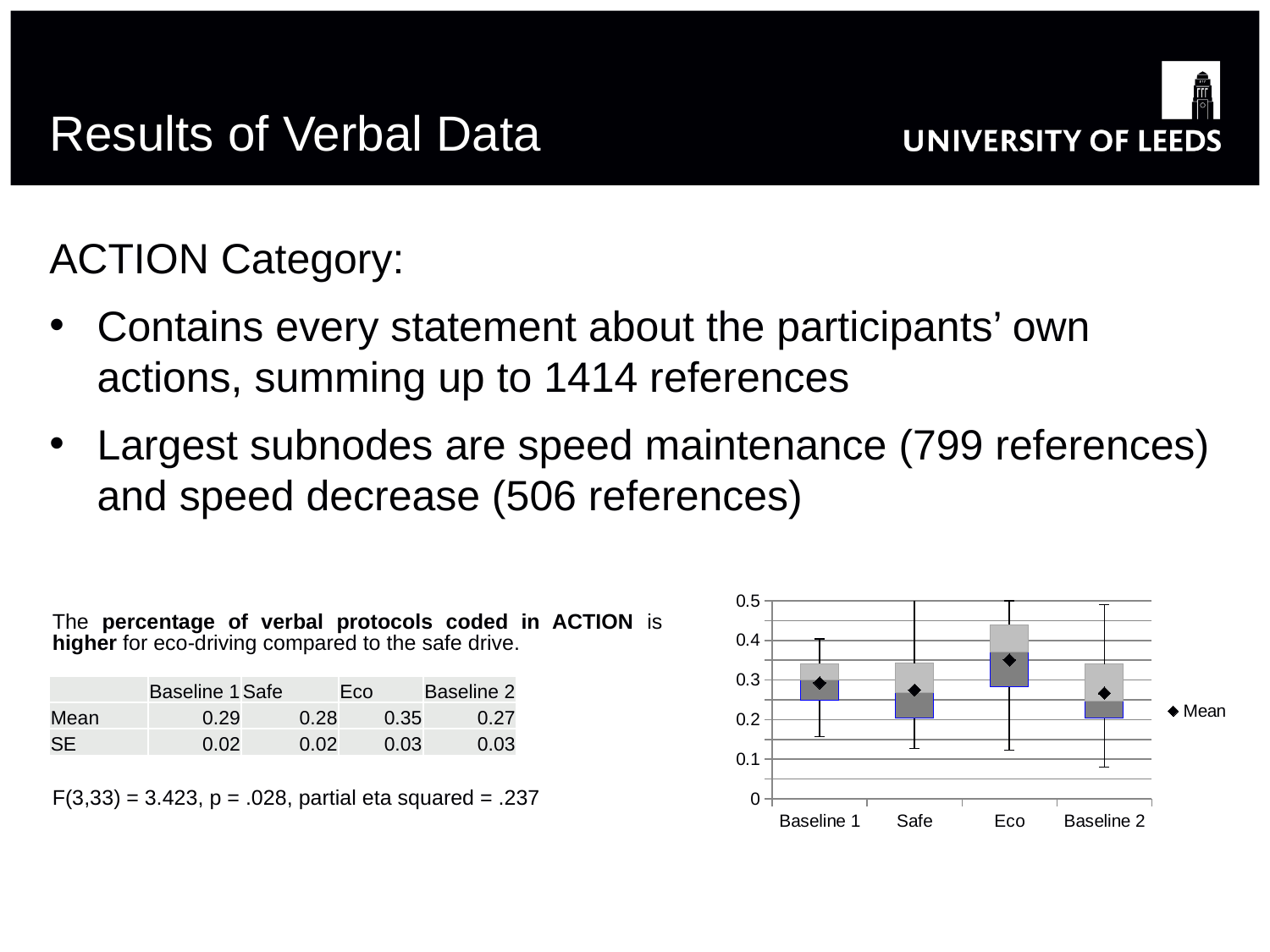
Which has the larger mean, Eco or Baseline 1? Eco What is the mean value plotted for Baseline 1? 0.29 How many categories are shown on the x axis of the chart? 4 Is the mean value for Eco greater or less than 0.3? greater What kind of chart is shown on the slide? Box plot (box-and-whisker chart) Is the mean value for Baseline 2 greater or less than 0.3? less Which category has the lowest mean in the chart? Baseline 2 Which category has the highest mean in the chart? Eco How many series does the chart legend list? 1 What is the mean value plotted for Eco? 0.35 What is the label of the only entry in the chart legend? Mean What is the difference between the mean for Eco and the mean for Safe? 0.07